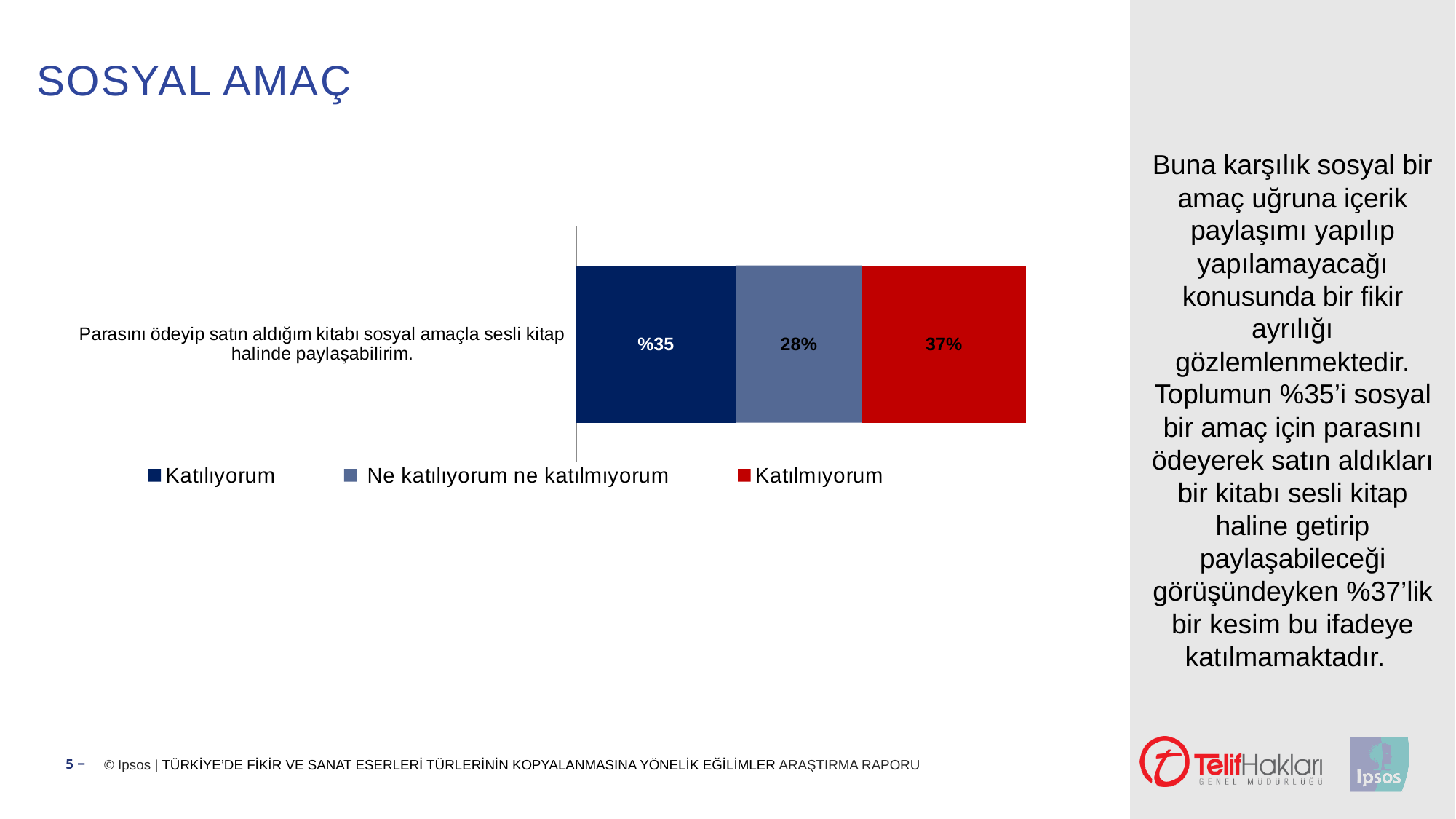
What percentage of respondents chose "Katılıyorum" for the statement "Parasını ödeyip satın aldığım kitabı sosyal amaçla sesli kitap halinde paylaşabilirim."? %35 What is the difference in percentage points between "Katılmıyorum" and "Katılıyorum"? 2 Which response option has the lowest share in the bar? Ne katılıyorum ne katılmıyorum What is the value shown for "Katılmıyorum"? 37% How many series does the legend list? 3 Which response option has the highest share in the bar? Katılmıyorum What is the total of the three segments in the stacked bar? 100% What colour is the "Katılmıyorum" segment in the chart? Red Which is larger, the share for "Katılıyorum" or the share for "Katılmıyorum"? Katılmıyorum What kind of chart is shown on the slide? Stacked bar chart What is the value shown for "Ne katılıyorum ne katılmıyorum"? 28% What is the difference in percentage points between "Katılıyorum" and "Ne katılıyorum ne katılmıyorum"? 7